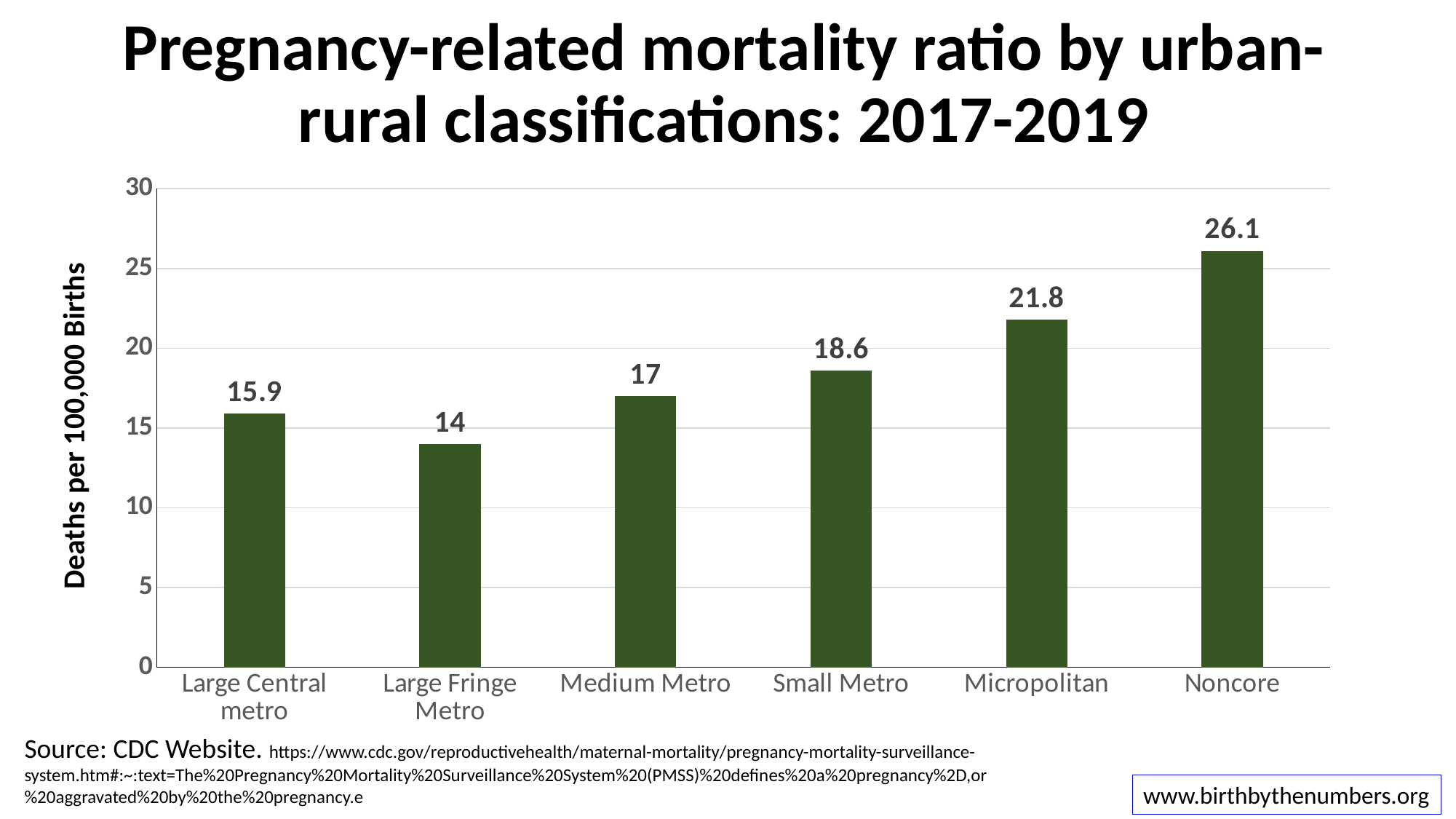
Which classification has the highest pregnancy-related mortality ratio? Noncore Which classification has the lowest pregnancy-related mortality ratio? Large Fringe Metro How many urban-rural classifications are shown on the chart? 6 What is the value shown for Small Metro? 18.6 What is the pregnancy-related mortality ratio for Noncore? 26.1 What kind of chart is shown on the slide? bar chart What is the difference between the values for Noncore and Large Central metro? 10.2 What is the difference between the values for Micropolitan and Medium Metro? 4.8 Is the value for Micropolitan greater or less than 20? greater What is the label of the vertical axis? Deaths per 100,000 Births What is the value shown for Large Fringe Metro? 14 Which has a higher value, Small Metro or Large Central metro? Small Metro